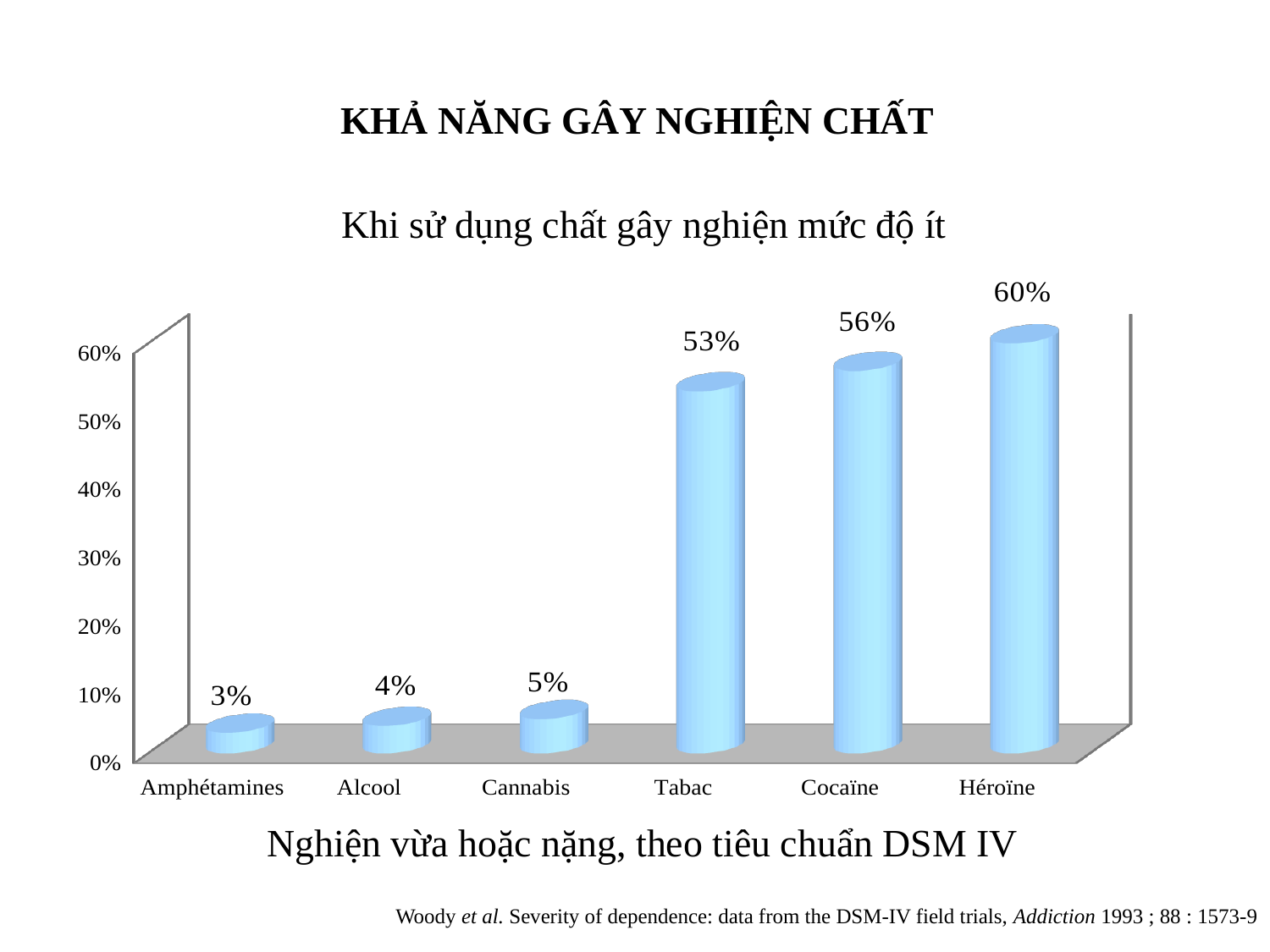
Which category has the highest value? Héroïne What is the title of the chart? KHẢ NĂNG GÂY NGHIỆN CHẤT What is the value for Amphétamines? 3% Which is larger, the value for Cocaïne or the value for Tabac? Cocaïne What is the difference between the values for Héroïne and Tabac? 7% Which category has the lowest value? Amphétamines What is the value for Tabac? 53% Is the value for Cannabis greater or less than 10%? less How many categories are shown on the x axis? 6 What is the difference between the values for Cannabis and Alcool? 1% What is the value for Cocaïne? 56% What kind of chart is shown on the slide? bar chart